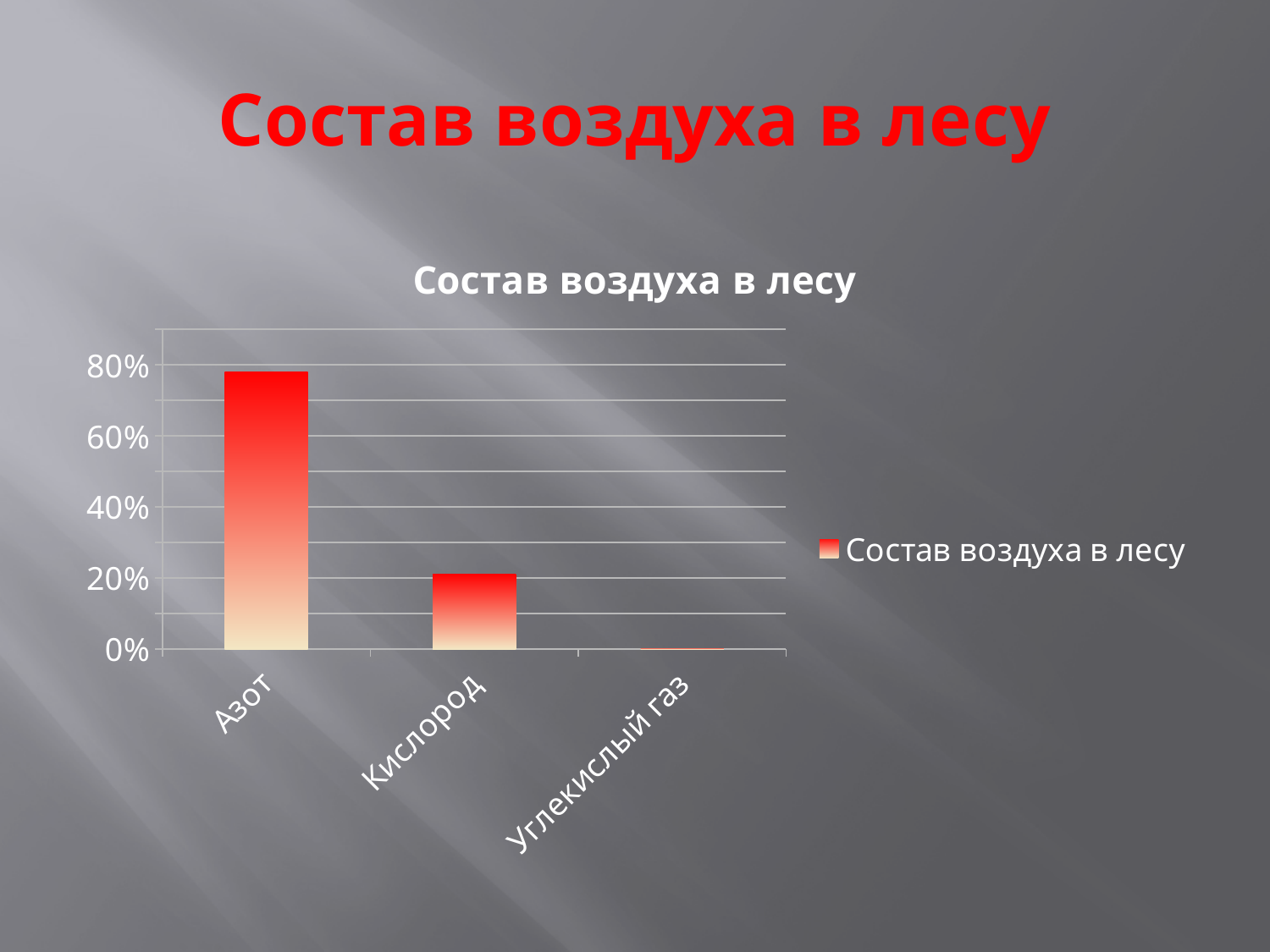
How many categories are shown on the x axis of the chart? 3 Is the value for Углекислый газ greater or less than 20%? less Is the value for Кислород greater or less than 40%? less How many series does the chart legend list? 1 Which category has the highest value in the chart? Азот Which is larger, the value for Кислород or the value for Углекислый газ? Кислород Which is larger, the value for Азот or the value for Кислород? Азот What kind of chart is shown on the slide? bar chart Do the values rise or fall moving from left to right along the x axis? fall What is the title of the chart? Состав воздуха в лесу Is the value for Азот greater or less than 60%? greater Which category has the lowest value in the chart? Углекислый газ